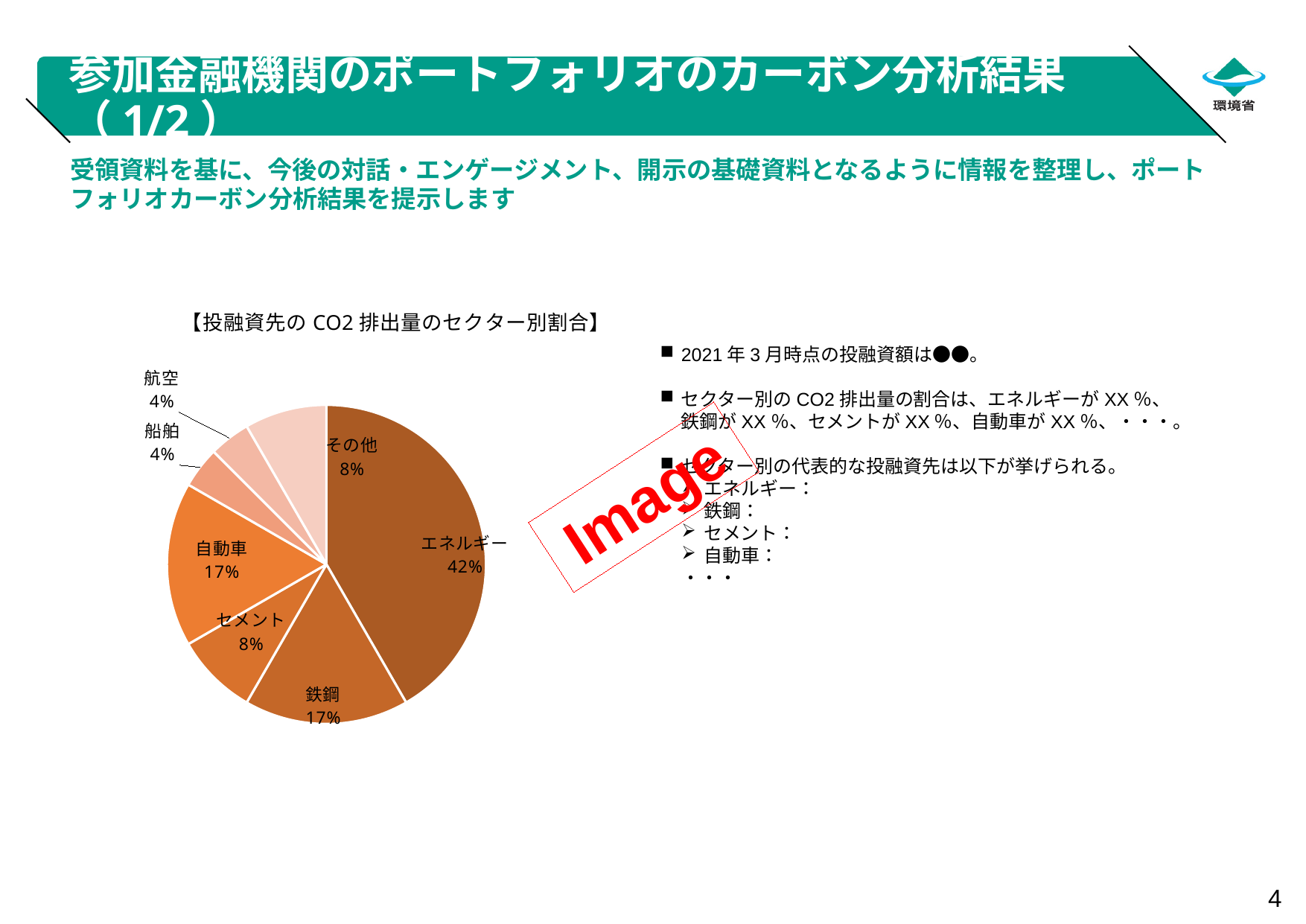
What is the share for その他 in the pie chart? 8% What is the share for セメント in the pie chart? 8% Which is larger, the share of セメント or the share of 鉄鋼? 鉄鋼 What is the share for エネルギー in the pie chart? 42% What is the difference between the shares of エネルギー and 自動車? 25% What kind of chart is shown on the slide? pie chart What is the share for 自動車 in the pie chart? 17% What is the share for 鉄鋼 in the pie chart? 17% Which sector has the largest share of the pie chart? エネルギー What is the share for 船舶 in the pie chart? 4% What is the title of the pie chart? 投融資先のCO2排出量のセクター別割合 How many slices does the pie chart have? 7